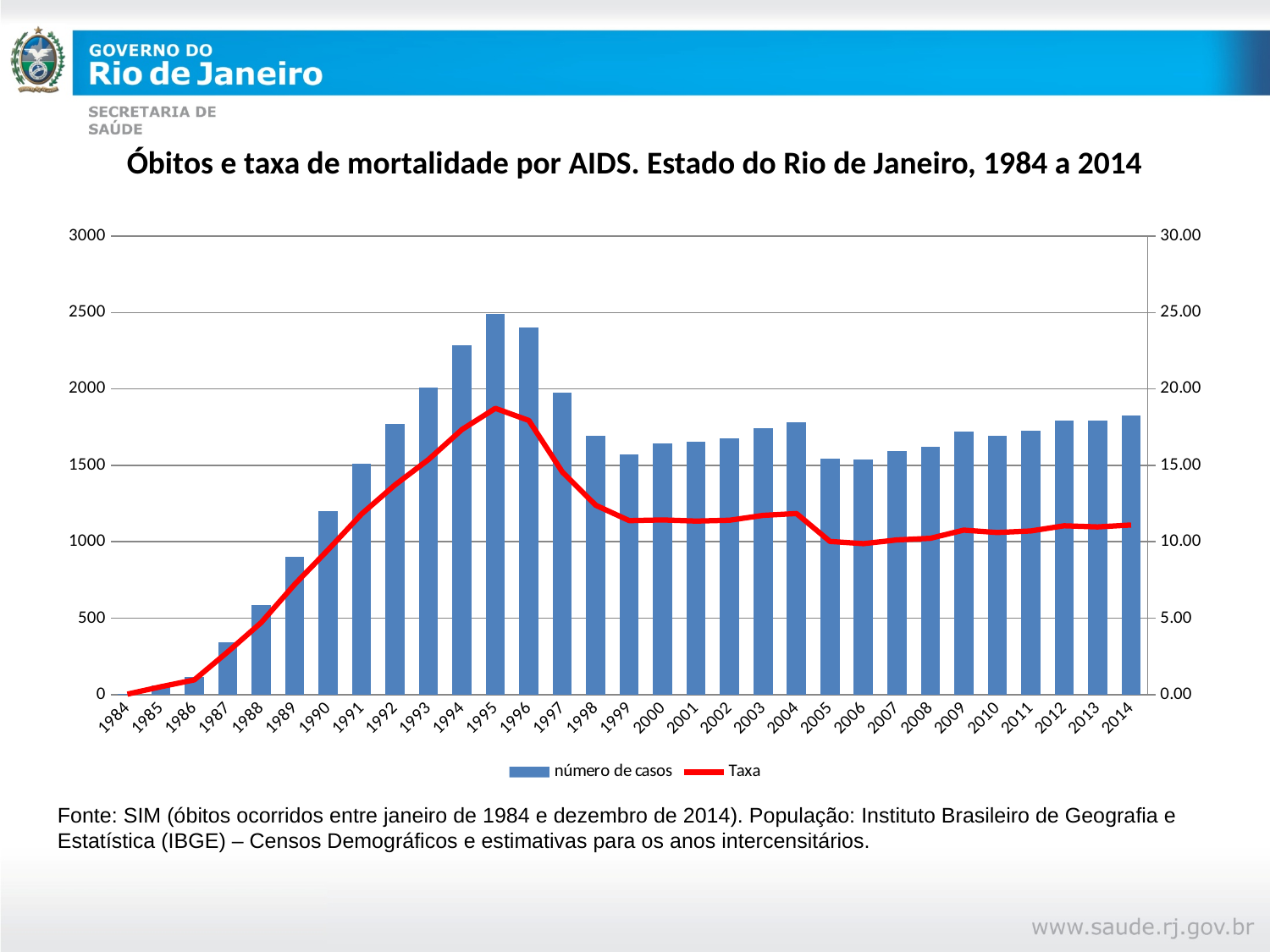
How many series does the legend list? 2 Is the número de casos bar for 1999 greater or less than 2000? less Which year has the higher número de casos bar, 1993 or 2004? 1993 What kind of chart is shown on the slide? A combined bar and line chart How many years are shown on the x axis? 31 Is the número de casos bar for 1995 greater or less than 2000? greater In which year is the bar for número de casos lowest? 1984 In which year is the bar for número de casos highest? 1995 Is the número de casos bar for 1988 greater or less than 1000? less What are the two series named in the legend? número de casos and Taxa Do the número de casos bars rise or fall from 1984 to 1995? rise